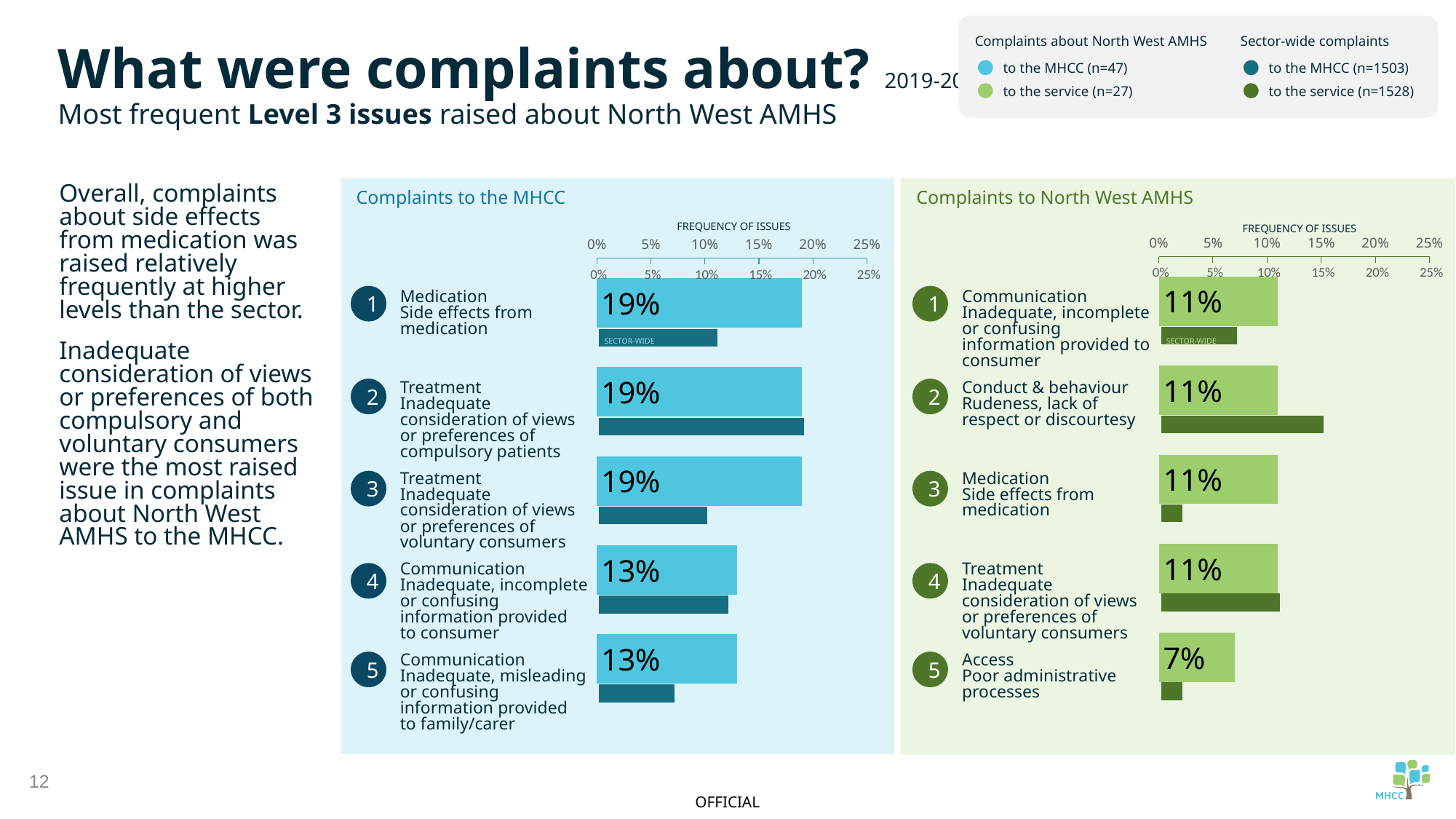
In the 'Complaints to the MHCC' chart, what is the frequency of issues for 'Communication – Inadequate, misleading or confusing information provided to family/carer'? 13% How many series does the legend at the top of the slide list? 4 In the 'Complaints to North West AMHS' chart, which issue has the lowest frequency? Access – Poor administrative processes In the 'Complaints to the MHCC' chart, is the sector-wide bar for 'Medication – Side effects from medication' greater or less than 15%? less In the 'Complaints to North West AMHS' chart, is the sector-wide bar for 'Conduct & behaviour – Rudeness, lack of respect or discourtesy' greater or less than 10%? greater In the 'Complaints to the MHCC' chart, what is the frequency of issues for 'Medication – Side effects from medication'? 19% In the 'Complaints to North West AMHS' chart, what is the difference between the frequency for 'Medication – Side effects from medication' and 'Access – Poor administrative processes'? 4% In the 'Complaints to North West AMHS' chart, what is the frequency of issues for 'Access – Poor administrative processes'? 7% In the 'Complaints to North West AMHS' chart, what is the frequency of issues for 'Conduct & behaviour – Rudeness, lack of respect or discourtesy'? 11% In the 'Complaints to the MHCC' chart, what is the difference between the frequency for 'Medication – Side effects from medication' and 'Communication – Inadequate, incomplete or confusing information provided to consumer'? 6% What kind of chart is used in the 'Complaints to North West AMHS' panel? Bar chart How many issues are listed in the 'Complaints to the MHCC' chart? 5